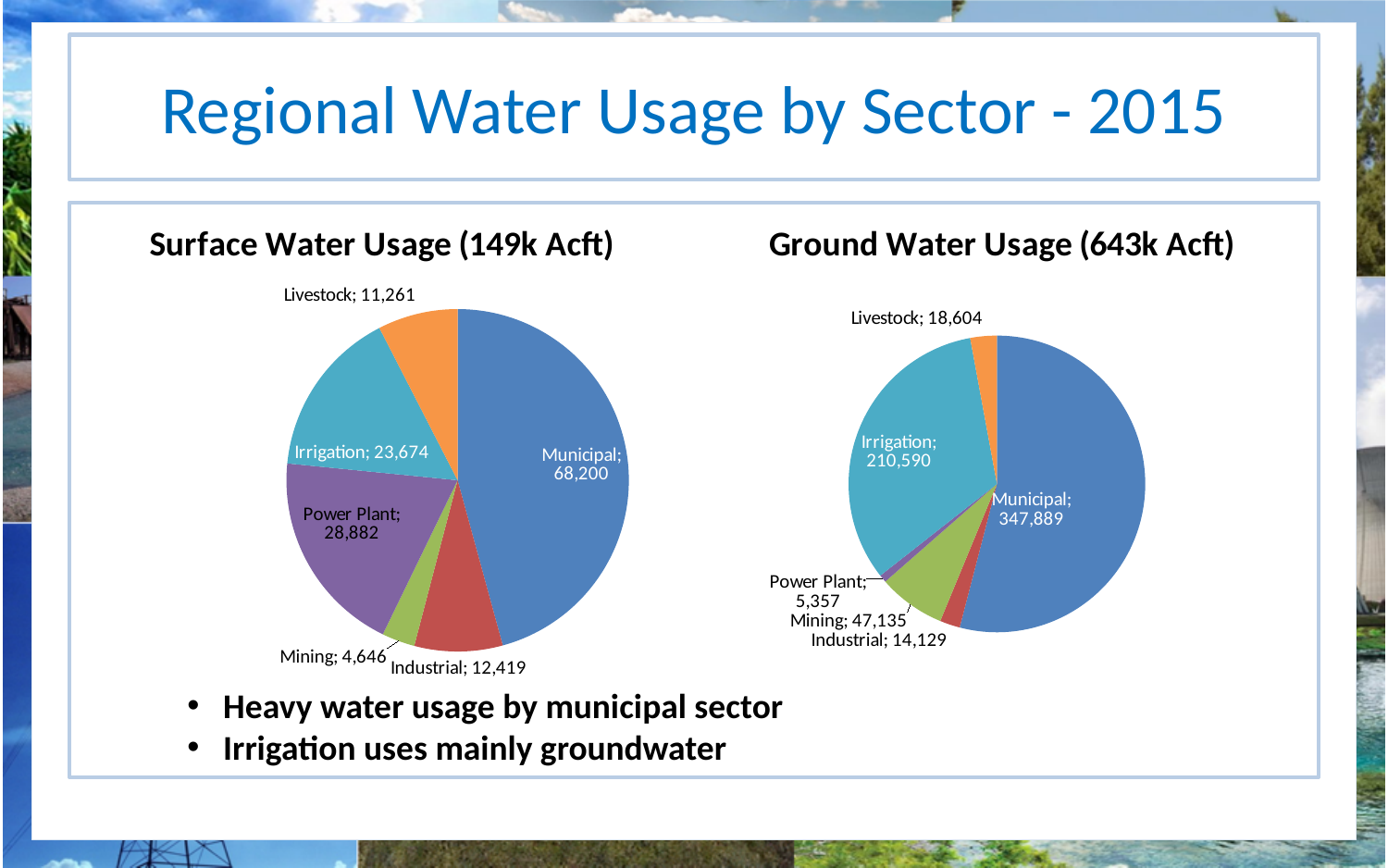
On the Ground Water Usage chart, what is the value for Mining? 47,135 What type of chart is the Ground Water Usage chart? Pie chart How many sectors are shown on the Surface Water Usage chart? 6 On the Ground Water Usage chart, which sector has the smallest slice? Power Plant On the Ground Water Usage chart, what is the difference between Municipal and Irrigation? 137,299 On the Surface Water Usage chart, which sector has the largest slice? Municipal On the Surface Water Usage chart, which sector has the smallest slice? Mining On the Ground Water Usage chart, what is the value for Irrigation? 210,590 On the Ground Water Usage chart, which is larger, Mining or Livestock? Mining On the Surface Water Usage chart, what is the value for Power Plant? 28,882 On the Surface Water Usage chart, what is the difference between Power Plant and Irrigation? 5,208 On the Surface Water Usage chart, what is the value for Municipal? 68,200